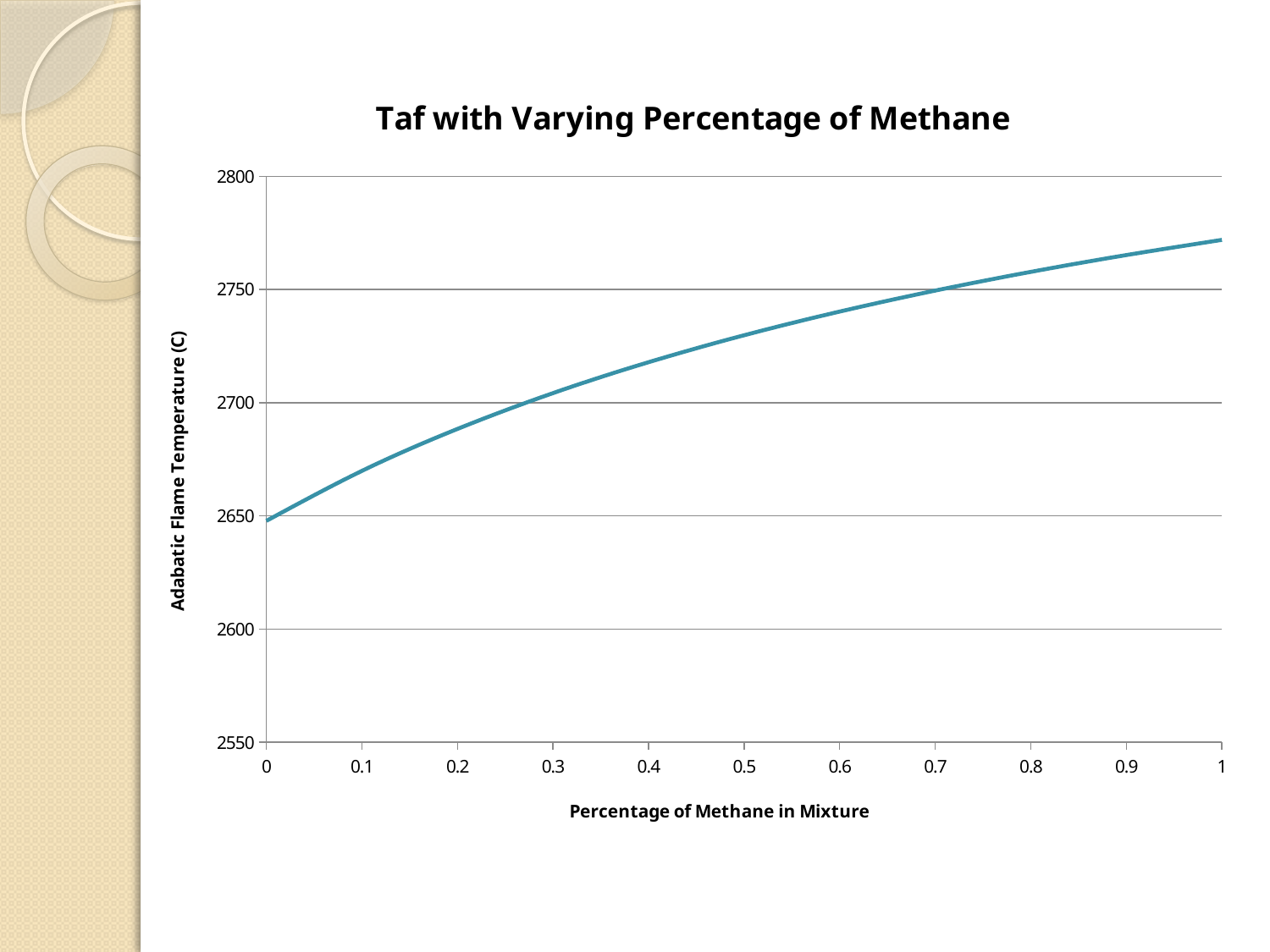
What is the title of the chart? Taf with Varying Percentage of Methane Is the adiabatic flame temperature at a methane percentage of 0.2 greater or less than 2700? less Is the adiabatic flame temperature at a methane percentage of 0.5 greater or less than 2700? greater Is the adiabatic flame temperature at a methane percentage of 0.1 greater or less than 2650? greater What is the label of the y axis? Adabatic Flame Temperature (C) At which percentage of methane is the adiabatic flame temperature lowest? 0 Does the adiabatic flame temperature rise or fall as the percentage of methane increases from 0 to 1? rise What kind of chart is shown on the slide? line chart At which percentage of methane is the adiabatic flame temperature highest? 1 Which has the higher adiabatic flame temperature, a methane percentage of 0.2 or 0.8? 0.8